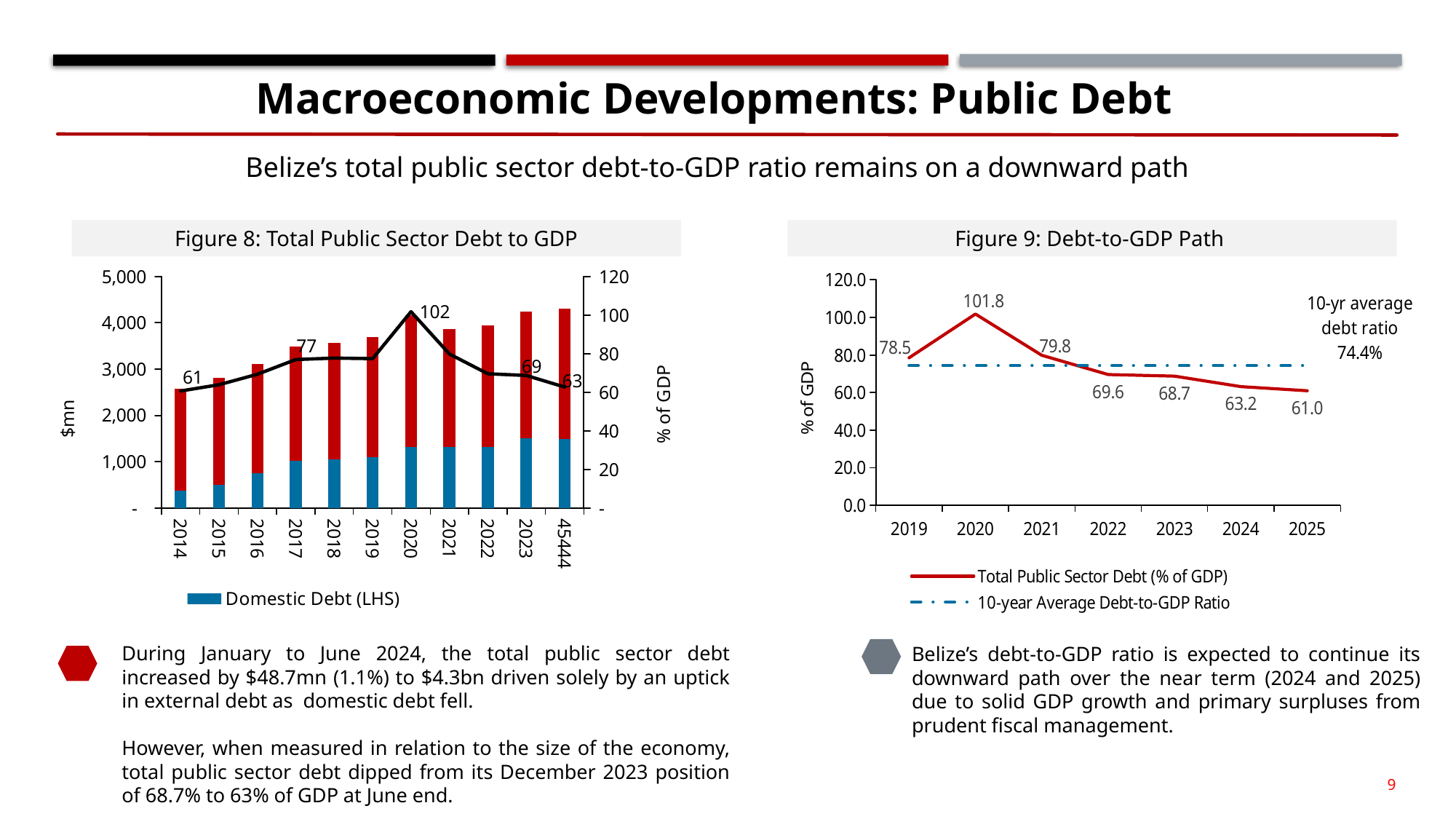
In Figure 9: Debt-to-GDP Path, what is the difference between the 2019 value (78.5) and the 2025 value (61.0)? 17.5 In Figure 9: Debt-to-GDP Path, what is the 10-yr average debt ratio shown on the chart? 74.4% In Figure 8: Total Public Sector Debt to GDP, is the total height of the 2023 bar greater or less than 4,000 $mn? greater In Figure 9: Debt-to-GDP Path, which year has the highest Total Public Sector Debt (% of GDP)? 2020 In Figure 8: Total Public Sector Debt to GDP, what is the difference between the % of GDP labels for 2020 (102) and 2023 (69)? 33 In Figure 8: Total Public Sector Debt to GDP, what is the % of GDP value labelled for 2020? 102 In Figure 9: Debt-to-GDP Path, what is the Total Public Sector Debt (% of GDP) value for 2020? 101.8 In Figure 9: Debt-to-GDP Path, does the Total Public Sector Debt (% of GDP) rise or fall from 2020 to 2025? fall In Figure 9: Debt-to-GDP Path, which year has the lowest Total Public Sector Debt (% of GDP)? 2025 In Figure 9: Debt-to-GDP Path, how many years are shown on the x axis? 7 In Figure 9: Debt-to-GDP Path, how many series does the legend list? 2 In Figure 8: Total Public Sector Debt to GDP, how many bars (categories) are shown on the x axis? 11